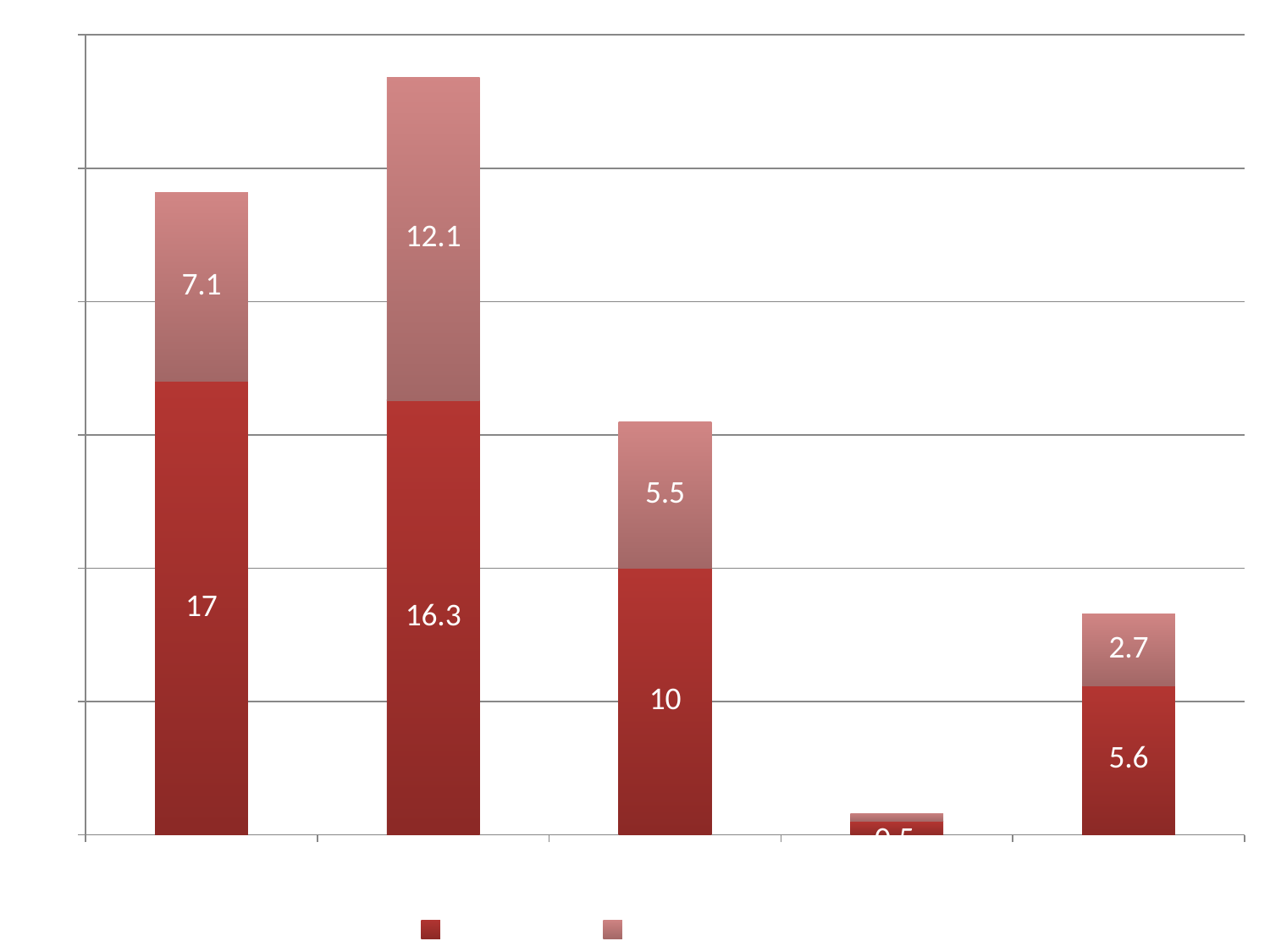
What kind of chart is shown on the slide? bar chart How many series does the legend list? 2 What is the value of the light pink segment of the second bar? 12.1 Which bar is the shortest overall? the fourth bar What is the value of the dark red segment of the third bar? 10 What is the total of the first (leftmost) stacked bar? 24.1 Which bar is the tallest overall? the second bar What is the value of the dark red segment of the first (leftmost) bar? 17 What is the difference between the light pink segments of the second bar and the first bar? 5 What is the value of the light pink segment of the fifth (rightmost) bar? 2.7 How many bars are plotted in the chart? 5 Which is larger, the dark red segment of the first bar or the dark red segment of the second bar? the first bar